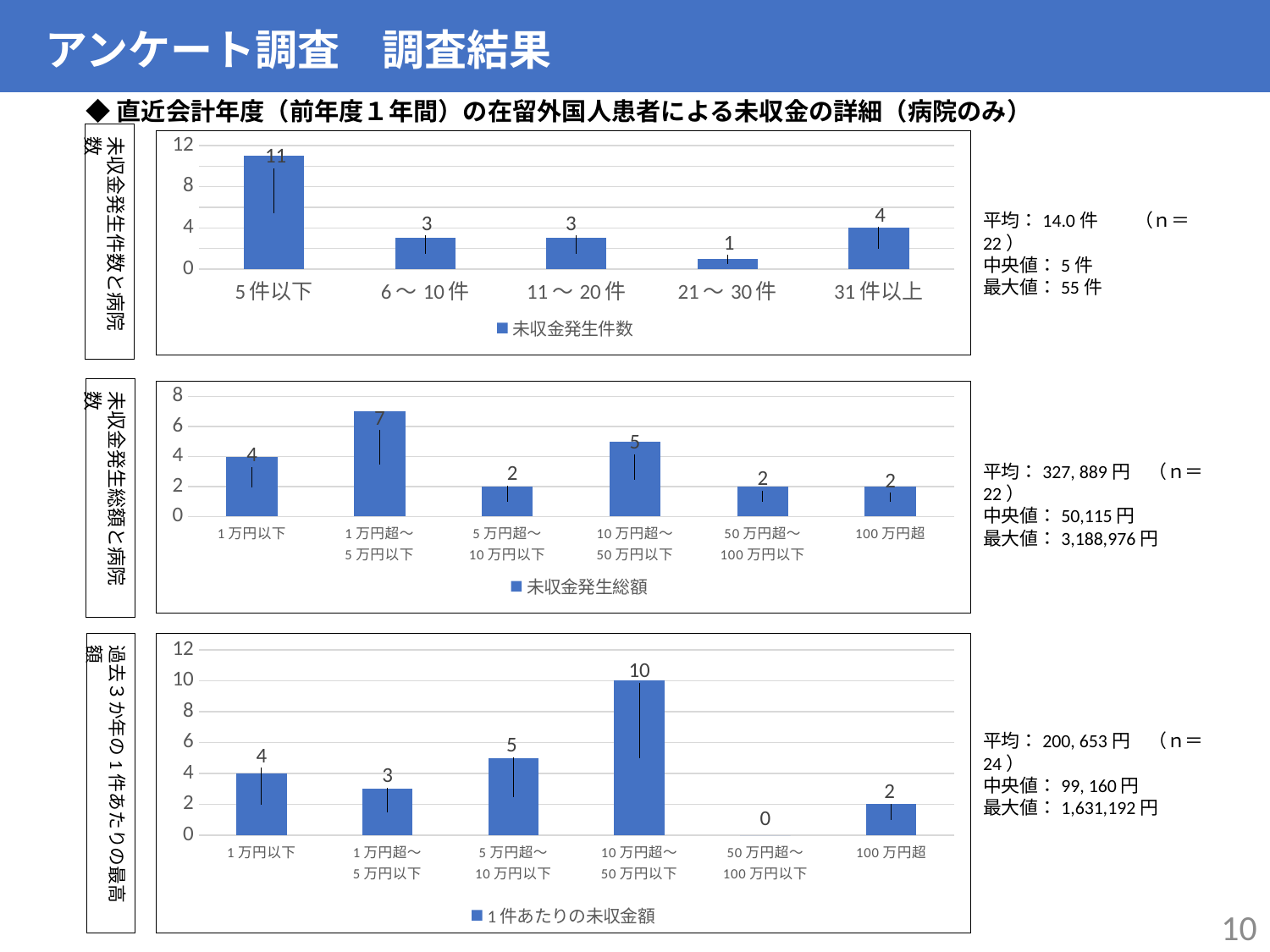
In the middle chart, what is the value for 1万円超～5万円以下? 7 How many categories are shown on the x axis of the top chart? 5 In the top chart, which category has the lowest value? 21～30件 In the bottom chart, what is the value for 10万円超～50万円以下? 10 In the top chart, which category has the highest value? 5件以下 In the bottom chart, which category has the lowest value? 50万円超～100万円以下 In the middle chart, which category has the highest value? 1万円超～5万円以下 What kind of chart is the bottom chart? Bar chart In the top chart, what is the value for 5件以下? 11 In the bottom chart, what is the difference between the values for 10万円超～50万円以下 and 5万円超～10万円以下? 5 In the top chart, what is the difference between the values for 5件以下 and 31件以上? 7 In the middle chart, which is larger, the value for 1万円以下 or the value for 10万円超～50万円以下? 10万円超～50万円以下